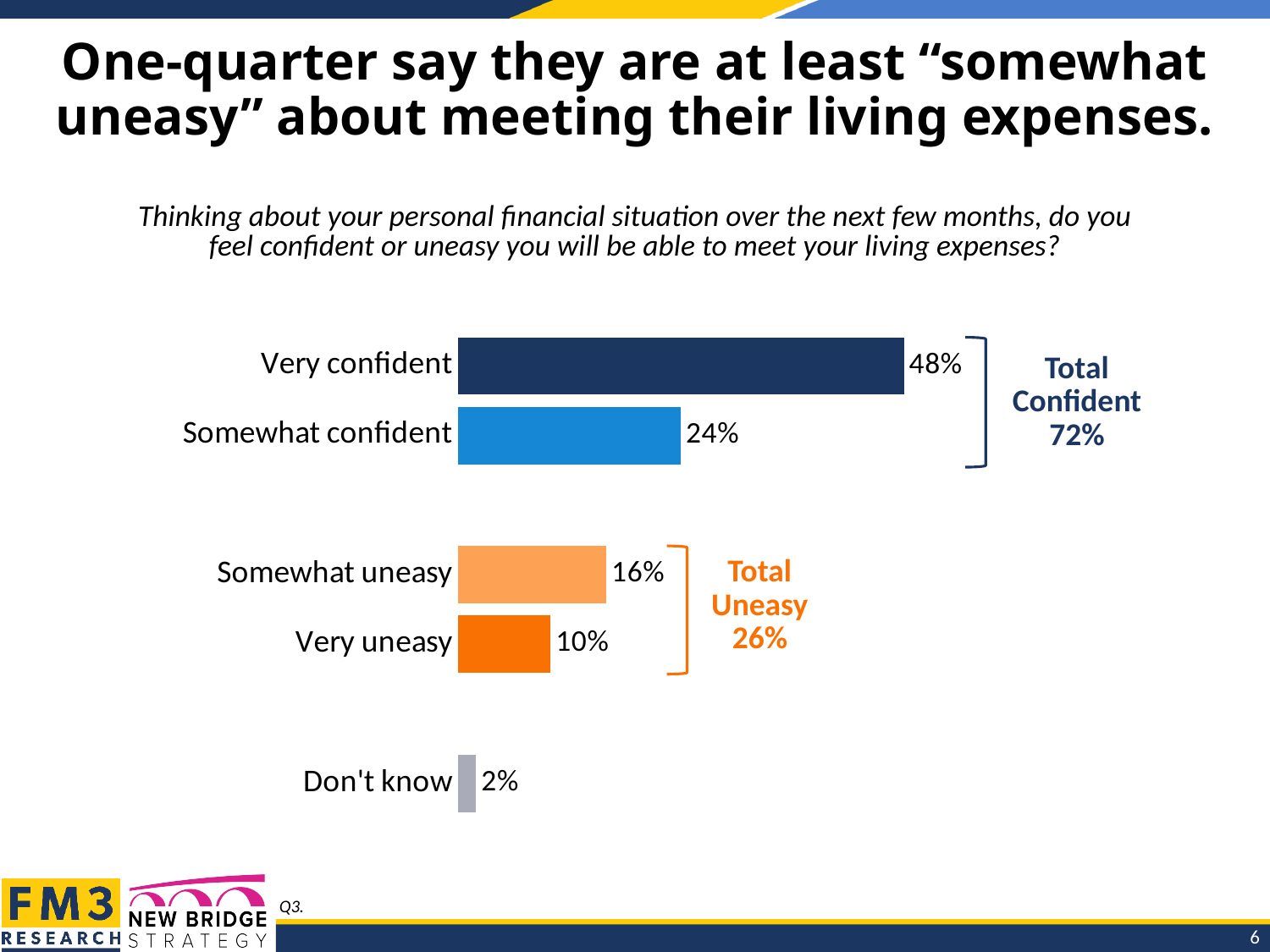
What percentage of respondents said they are somewhat confident? 24% How many response categories are shown in the chart? 5 Which is larger, the percentage for "Somewhat uneasy" or for "Very uneasy"? Somewhat uneasy What percentage of respondents said they are very confident about meeting their living expenses? 48% What type of chart is shown on the slide? Bar chart What is the Total Uneasy percentage shown next to the chart? 26% Which response category has the lowest percentage? Don't know What percentage of respondents said they are very uneasy? 10% What is the difference in percentage points between "Very confident" and "Somewhat confident"? 24 What percentage of respondents said they are somewhat uneasy? 16% What percentage of respondents answered "Don't know"? 2% Which response category has the highest percentage? Very confident